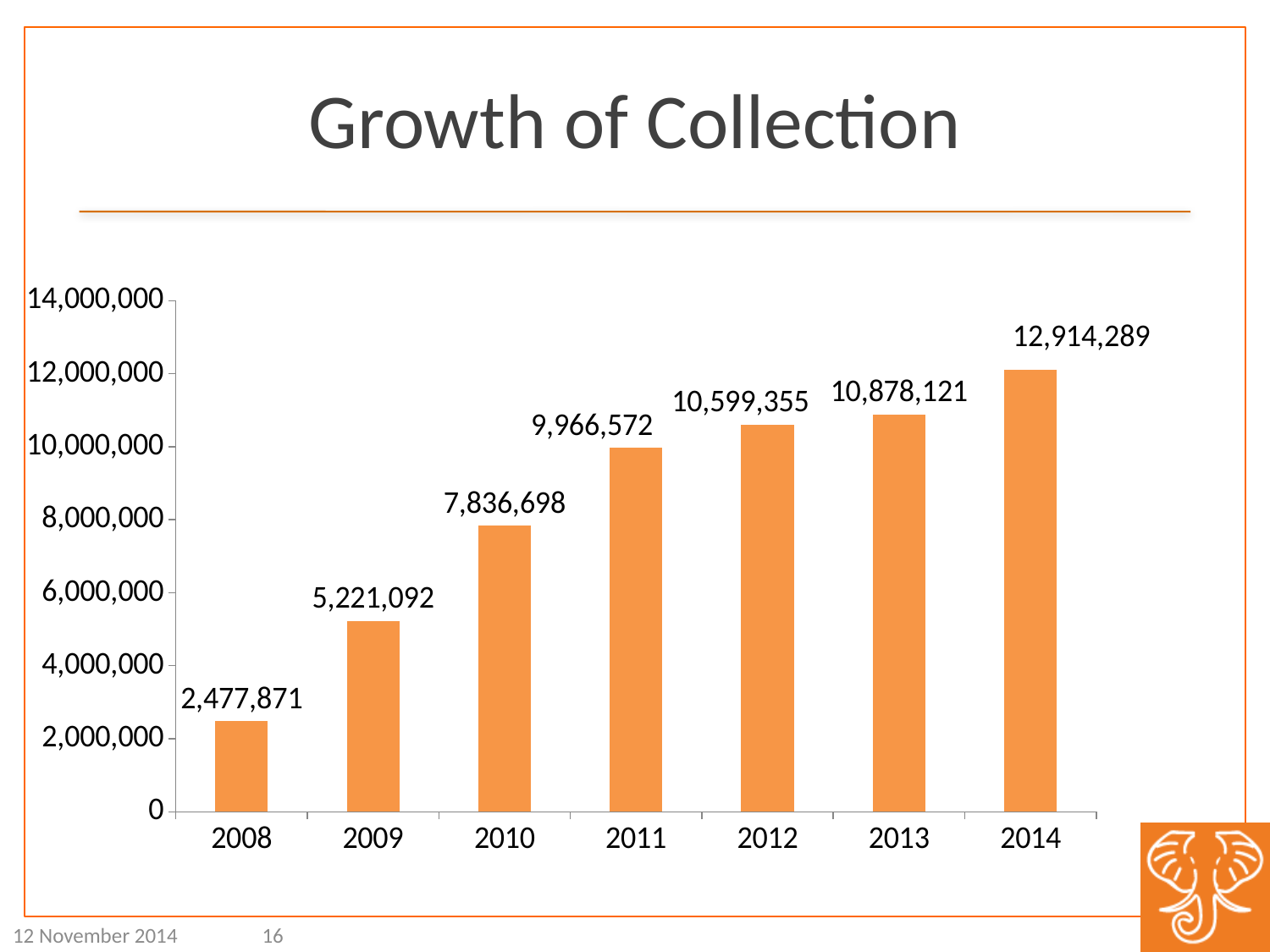
What is the value for 2014? 12,914,289 What is the difference between the values for 2011 and 2010? 2,129,874 Which is larger, the value for 2012 or the value for 2010? 2012 What kind of chart is this? bar chart Which year has the highest value? 2014 What is the value for 2008? 2,477,871 What is the value for 2011? 9,966,572 Do the values rise or fall from 2008 to 2014? rise Is the value for 2010 greater or less than 8,000,000? less What is the difference between the values for 2009 and 2008? 2,743,221 How many years are shown on the x axis? 7 Which year has the lowest value? 2008